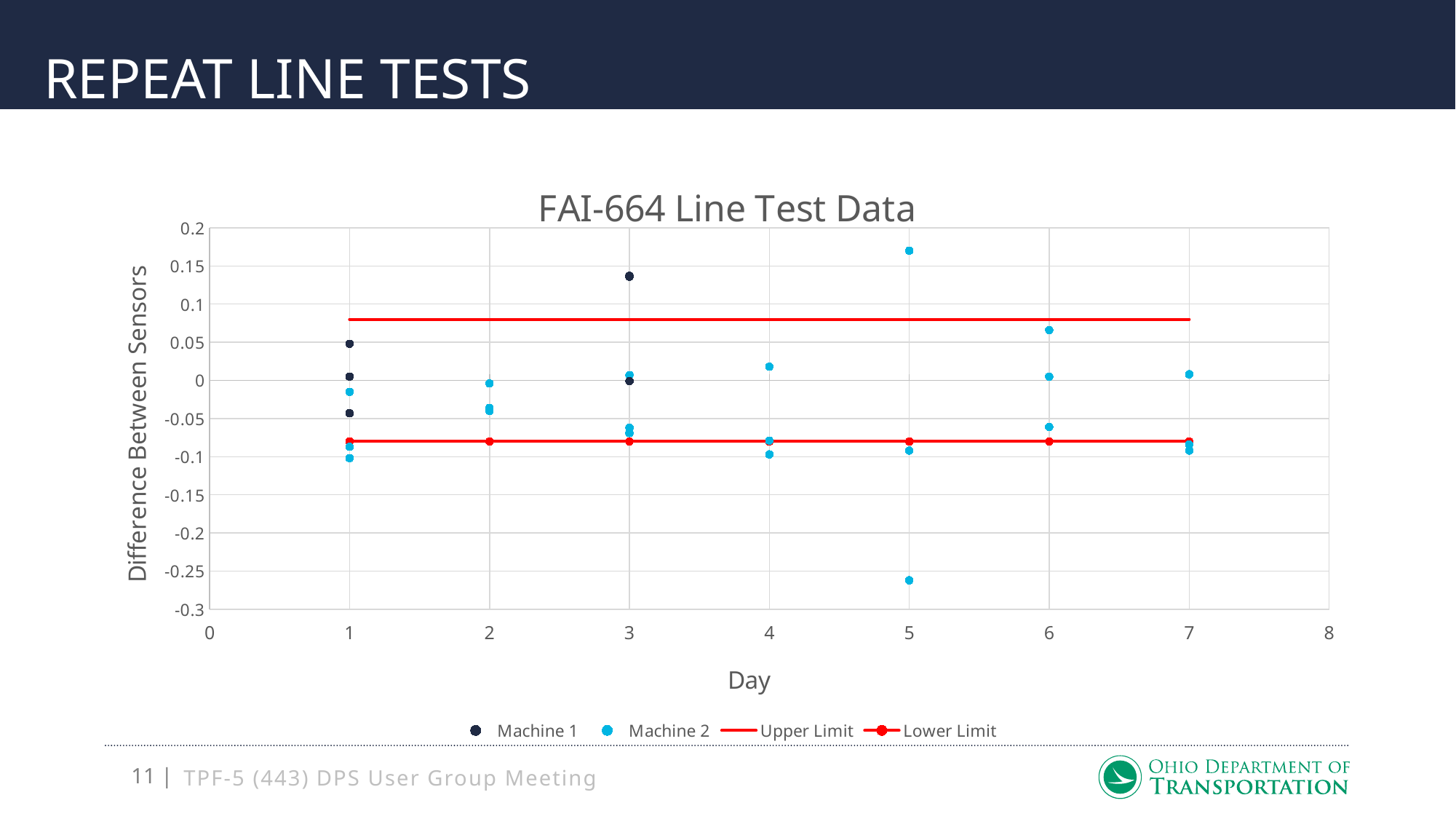
On how many days are data points plotted? 7 Is the Upper Limit line greater or less than 0.05? greater On which day does Machine 2 have its highest point? Day 5 Is the highest Machine 2 value on day 5 greater or less than 0.15? greater What kind of chart is shown on the slide? Scatter chart Which is higher: the highest Machine 2 point on day 5 or the highest Machine 1 point on day 3? Machine 2 on day 5 On which day does Machine 1 have its highest point? Day 3 What is the title of the chart? FAI-664 Line Test Data Is the lowest Machine 2 value on day 5 greater or less than -0.25? less On which day does Machine 2 have its lowest point? Day 5 What is the label of the vertical axis? Difference Between Sensors How many series does the chart legend list? 4